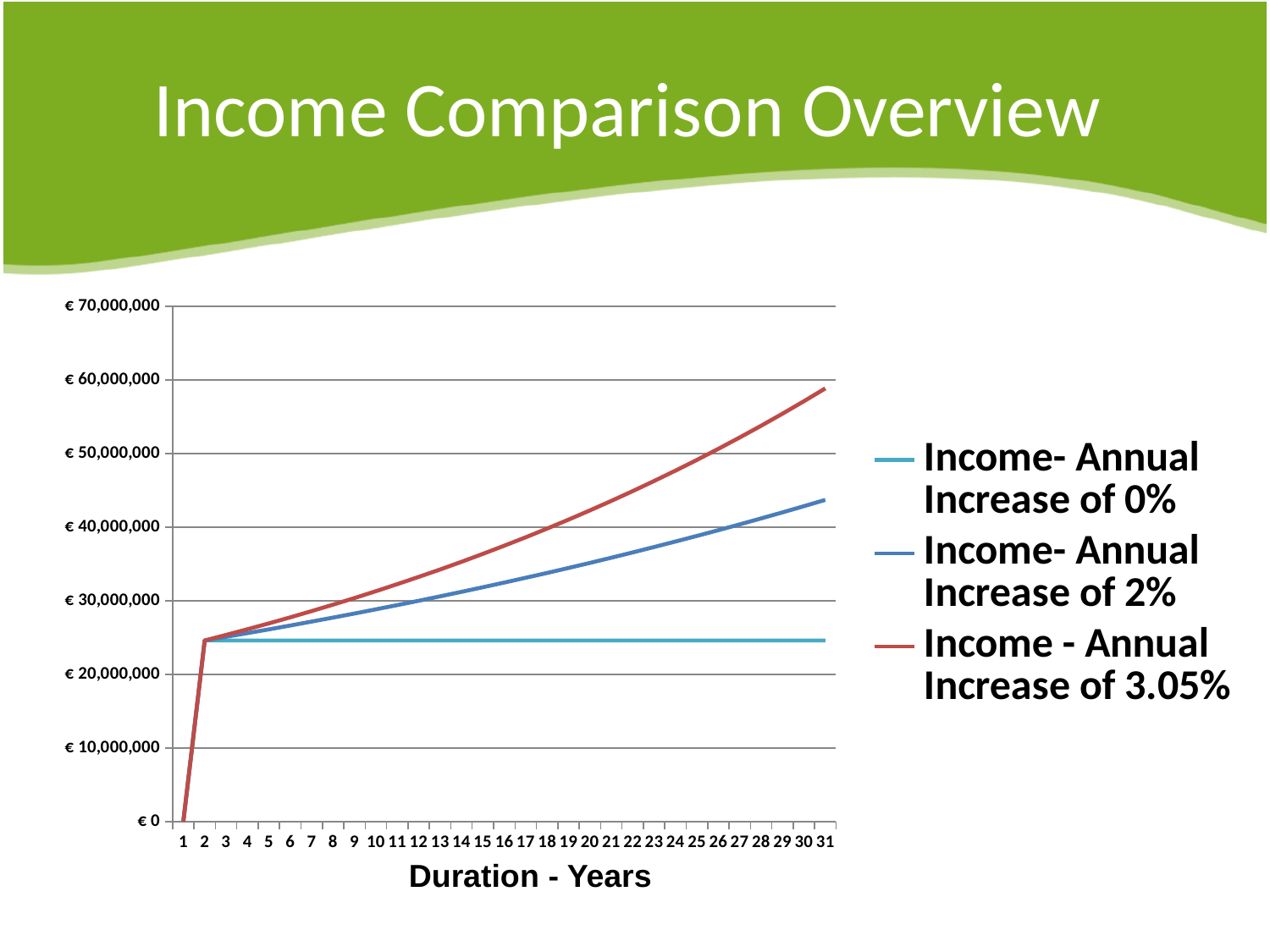
What kind of chart is shown on the slide? line chart How many series does the legend list? 3 Which series has the lowest value at year 31? Income- Annual Increase of 0% Is the value for Income- Annual Increase of 0% at year 31 greater or less than € 30,000,000? less What is the value of all three income series at year 1? € 0 How many years are shown along the x axis? 31 What is the title of the x axis? Duration - Years Is the value for Income- Annual Increase of 2% at year 31 greater or less than € 50,000,000? less From year 2 to year 31, does the Income- Annual Increase of 0% series rise, fall, or stay flat? stay flat At year 20, which is larger: Income- Annual Increase of 2% or Income - Annual Increase of 3.05%? Income - Annual Increase of 3.05% Is the value for Income - Annual Increase of 3.05% at year 31 greater or less than € 50,000,000? greater Which series has the highest value at year 31? Income - Annual Increase of 3.05%